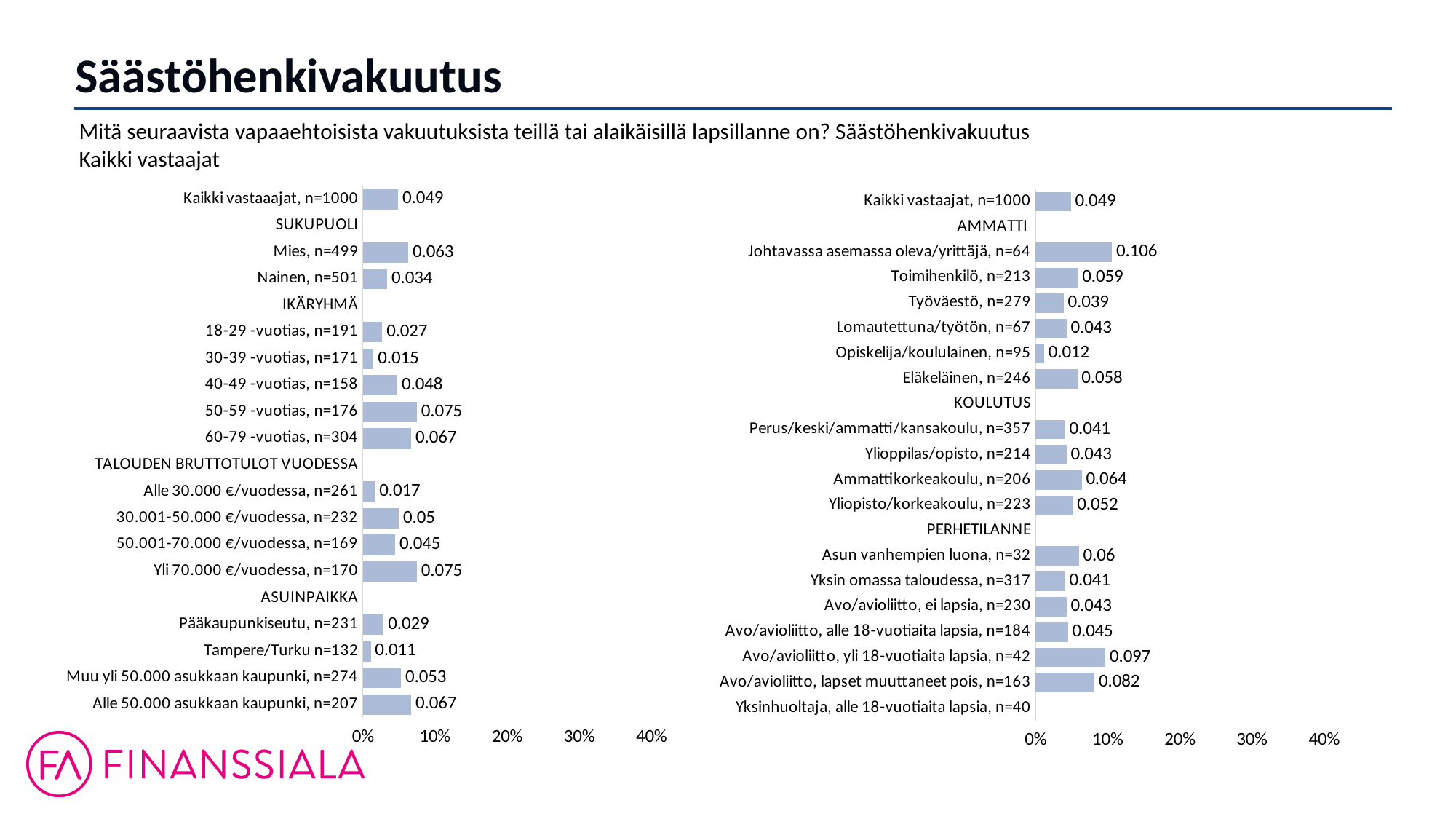
In the left chart, is the value for Yli 70.000 €/vuodessa, n=170 greater or less than 10%? less In the right chart, which is larger: the value for Toimihenkilö, n=213 or Työväestö, n=279? Toimihenkilö, n=213 In the left chart, which category has the lowest value? Tampere/Turku n=132 In the right chart, what is the value for Avo/avioliitto, lapset muuttaneet pois, n=163? 0.082 In the right chart, is the value for Johtavassa asemassa oleva/yrittäjä, n=64 greater or less than 10%? greater In the left chart, what is the value for 50-59 -vuotias, n=176? 0.075 In the right chart, which category has the highest value? Johtavassa asemassa oleva/yrittäjä, n=64 In the left chart, what is the difference between the values for Mies, n=499 and Nainen, n=501? 0.029 In the left chart, what is the value for Mies, n=499? 0.063 What kind of chart is the left chart? bar chart What is the value for Kaikki vastaajat, n=1000 in the right chart? 0.049 In the right chart, what is the value for Johtavassa asemassa oleva/yrittäjä, n=64? 0.106